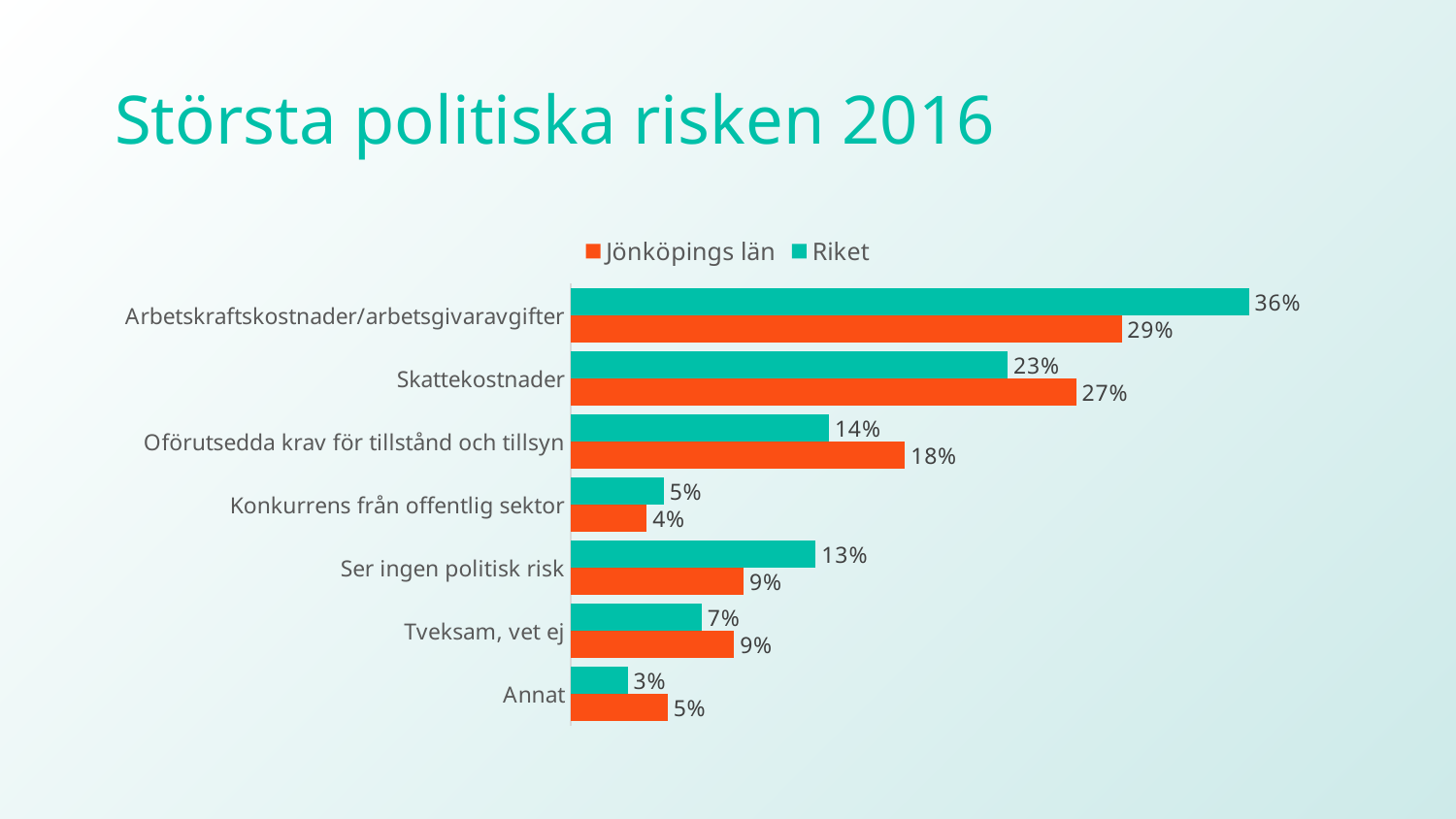
Which category has the highest value for Jönköpings län? Arbetskraftskostnader/arbetsgivaravgifter What is the title of the slide? Största politiska risken 2016 What is the difference between the Riket and Jönköpings län values for Arbetskraftskostnader/arbetsgivaravgifter? 7% What is the value for Riket for Ser ingen politisk risk? 13% Which category has the lowest value for Riket? Annat How many categories are shown on the chart? 7 How many series does the legend list? 2 For Skattekostnader, which is larger: the value for Jönköpings län or for Riket? Jönköpings län What is the value for Jönköpings län for Oförutsedda krav för tillstånd och tillsyn? 18% What is the value for Jönköpings län for Skattekostnader? 27% What is the value for Riket for Arbetskraftskostnader/arbetsgivaravgifter? 36% What kind of chart is shown on the slide? Bar chart